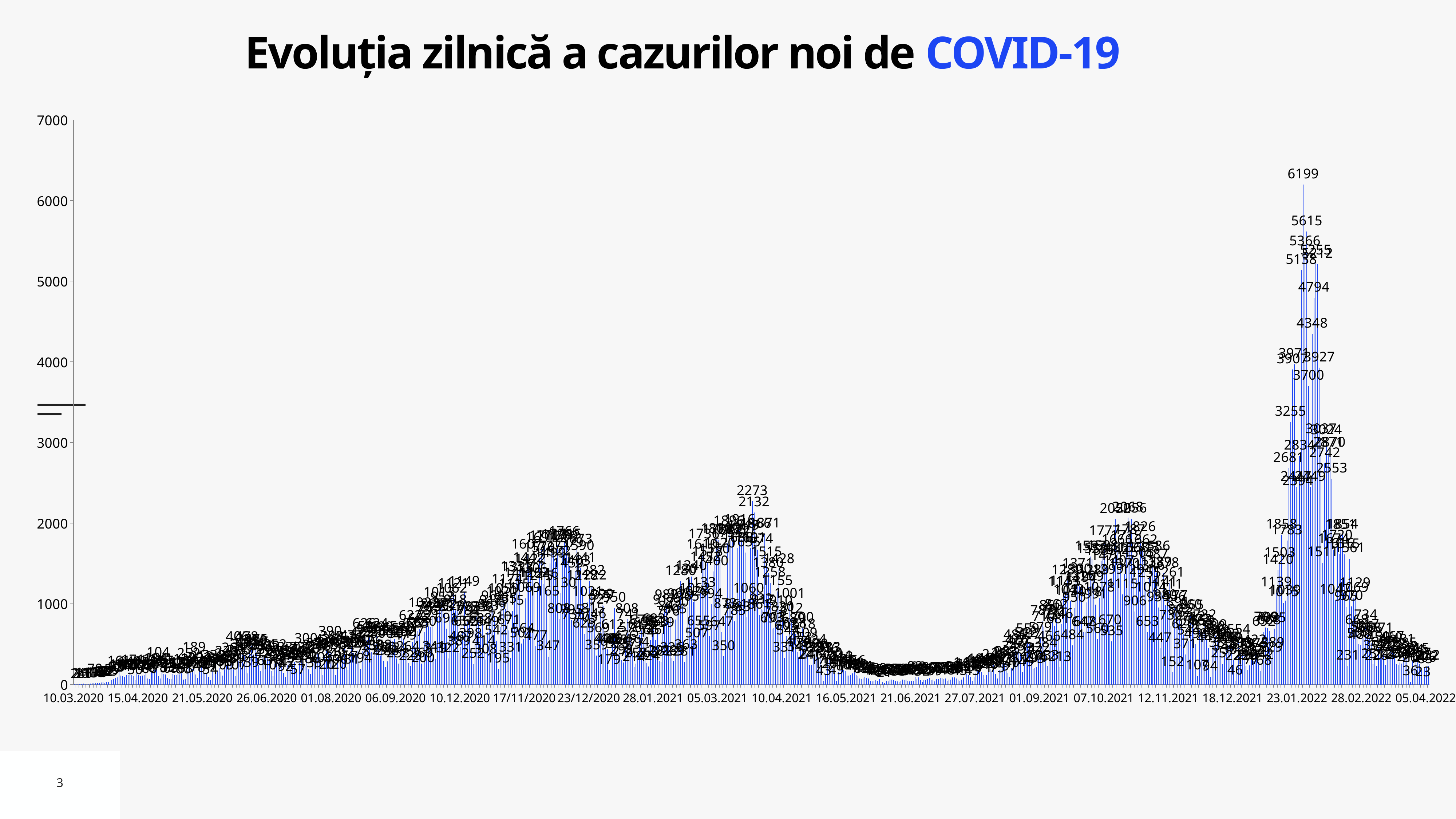
What is the highest value labeled on the chart? 6199 What is the highest value shown on the vertical axis? 7000 What kind of chart is shown on the slide? bar chart Is the highest value on the chart greater or less than 6000? greater Which is larger: the peak around 23.01.2022 or the peak around 05.03.2021? the peak around 23.01.2022 Do the values rise or fall from the peak near 23.01.2022 to 05.04.2022? fall What is the title of the chart? Evoluția zilnică a cazurilor noi de COVID-19 Is the value at 10.03.2020, the first date on the x axis, greater or less than 1000? less What is the highest labeled value in the wave around 05.03.2021? 2273 What is the difference between the two highest labeled values, 6199 and 5615? 584 Are the values around 21.06.2021 greater or less than 1000? less